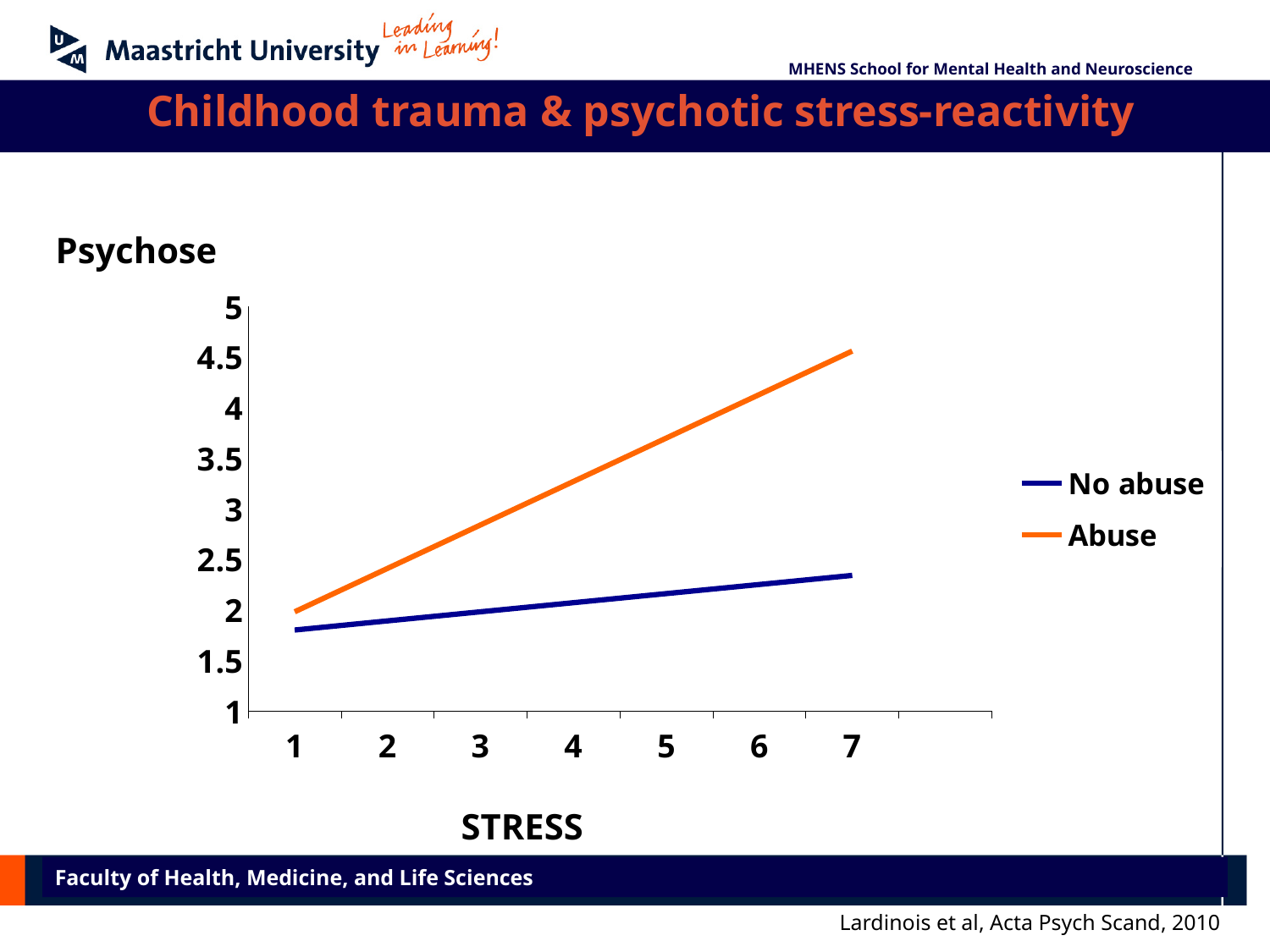
Is the Psychose value for Abuse at stress level 7 greater or less than 4? greater Which series rises more steeply with stress, Abuse or No abuse? Abuse Is the Psychose value for Abuse at stress level 1 greater or less than 3? less Is the Psychose value for No abuse at stress level 7 greater or less than 3? less How many series does the legend list? 2 Does the Abuse line rise or fall as stress increases from 1 to 7? rise What is the label of the x axis? STRESS How many stress levels are labelled along the x axis? 7 What are the two series named in the legend? No abuse and Abuse What kind of chart is shown on the slide? line chart Does the No abuse line rise or fall as stress increases from 1 to 7? rise At stress level 7, which series has the higher Psychose value, Abuse or No abuse? Abuse